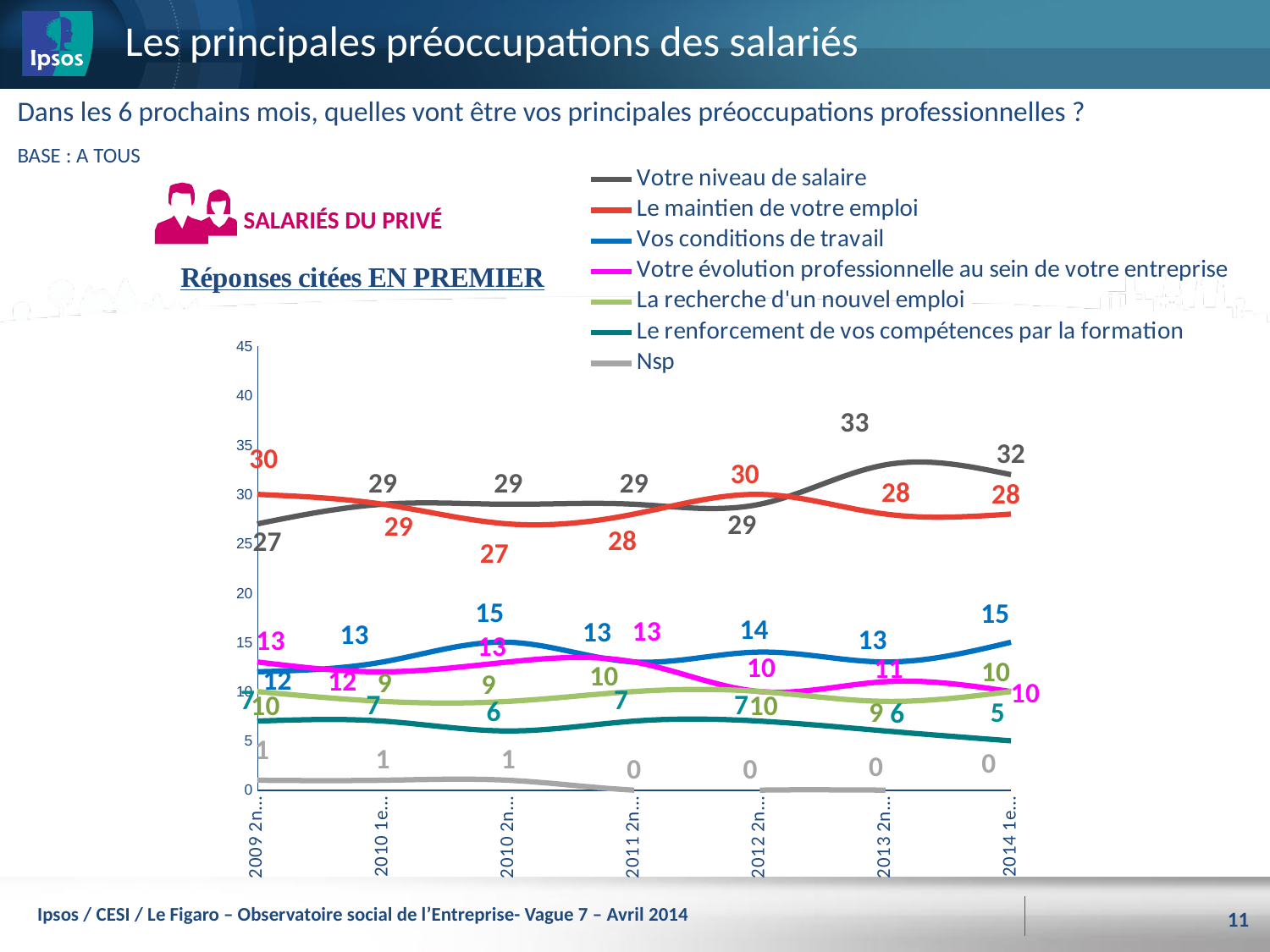
At the first point (2009 2n...), which is larger: 'Votre niveau de salaire' or 'Le maintien de votre emploi'? Le maintien de votre emploi What is the value for 'Le maintien de votre emploi' at the first point (2009 2n...)? 30 At which x-axis point is 'Le renforcement de vos compétences par la formation' at its lowest value? 2014 1e... What kind of chart is shown on the slide? line chart How many series does the legend list? 7 What colour is the line for 'Le maintien de votre emploi'? red At which x-axis point does 'Votre niveau de salaire' reach its highest value? 2013 2n... Does the 'Nsp' series rise or fall from the first point to the last point? fall How many points along the x axis does each series have? 7 What is the value for 'Votre niveau de salaire' at the 2013 2n... point? 33 At the last point (2014 1e...), what is the difference between 'Votre niveau de salaire' and 'Le maintien de votre emploi'? 4 What is the value for 'Vos conditions de travail' at the 2010 2n... point? 15